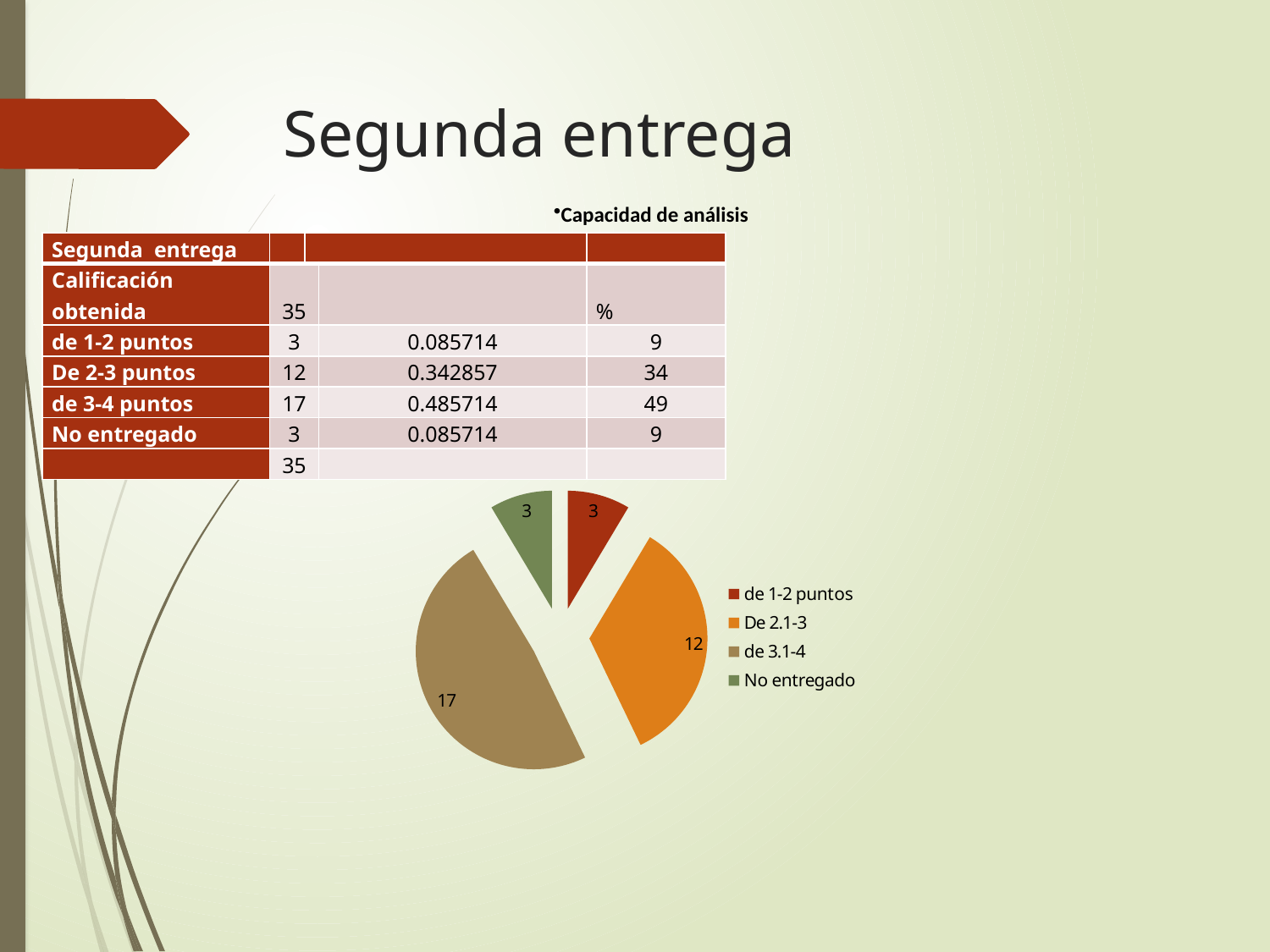
What type of chart is shown on the slide? pie chart What is the total of all the slice values in the pie chart? 35 What is the value of the 'No entregado' slice in the pie chart? 3 How many slices does the pie chart have? 4 What is the value of the 'de 3.1-4' slice in the pie chart? 17 Which is larger in the pie chart, 'De 2.1-3' or 'de 1-2 puntos'? De 2.1-3 Which category has the largest slice in the pie chart? de 3.1-4 What is the value of the 'De 2.1-3' slice in the pie chart? 12 What is the value of the 'de 1-2 puntos' slice in the pie chart? 3 What is the difference between the 'De 2.1-3' slice and the 'No entregado' slice? 9 How many entries does the pie chart's legend list? 4 What is the difference between the 'de 3.1-4' slice and the 'De 2.1-3' slice? 5